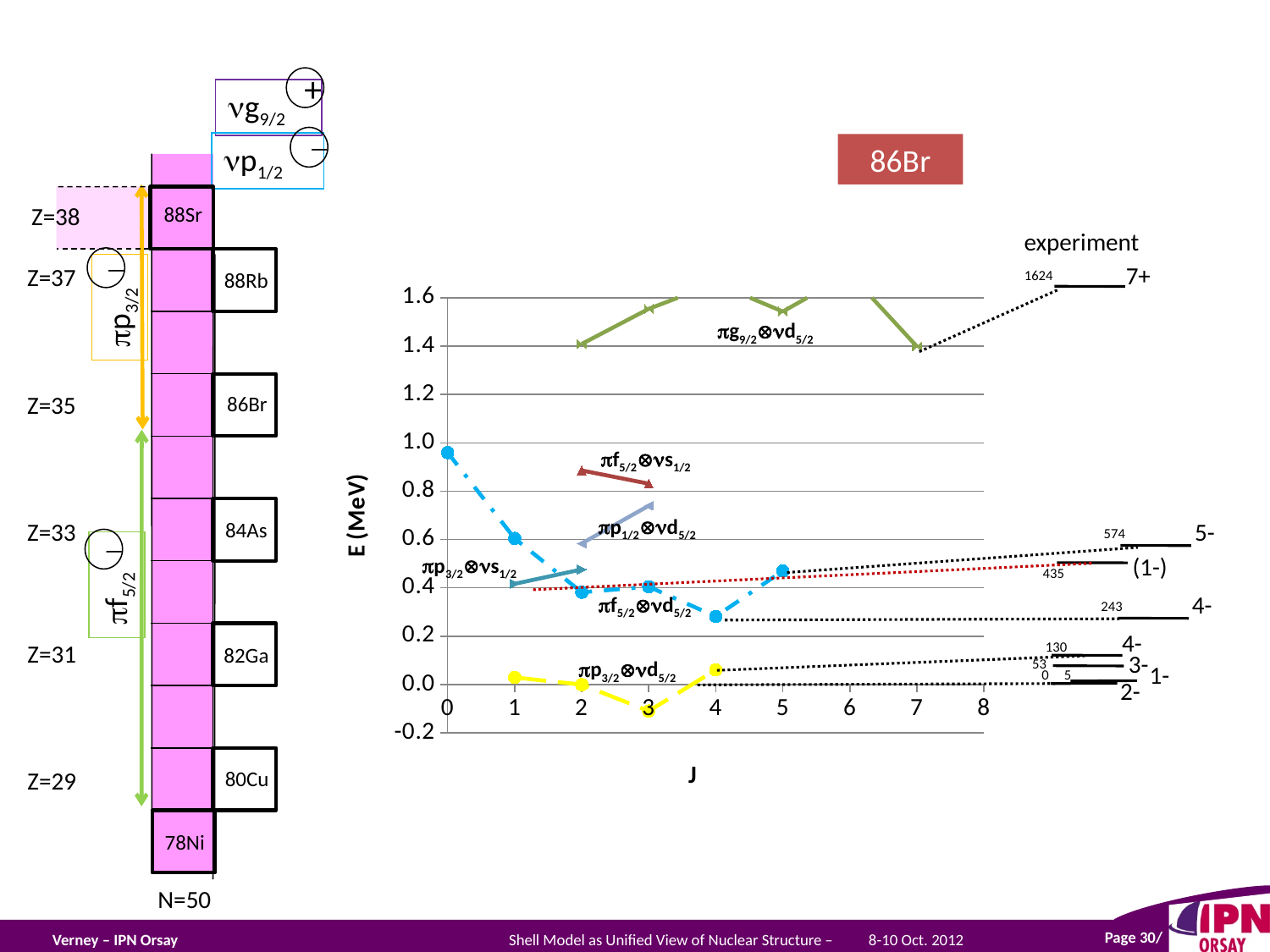
Is the value of the πf5/2⊗νd5/2 series at J=0 greater or less than 0.8 MeV? greater What is the label of the y axis of the chart? E (MeV) What kind of chart is shown on the slide? line chart Is the value of the πg9/2⊗νd5/2 series at J=3 greater or less than 1.4 MeV? greater Does the πf5/2⊗νd5/2 series rise or fall from J=0 to J=4? fall How many configuration series (πg9/2⊗νd5/2, πf5/2⊗νs1/2, etc.) are labelled on the chart? 6 What is the label of the x axis of the chart? J Is the value of the πp3/2⊗νd5/2 series at J=3 greater or less than 0.0 MeV? less What experimental energy (in keV) is printed next to the 7+ level on the right of the chart? 1624 Which labelled series lies highest in energy on the chart? πg9/2⊗νd5/2 Which labelled series lies lowest in energy on the chart? πp3/2⊗νd5/2